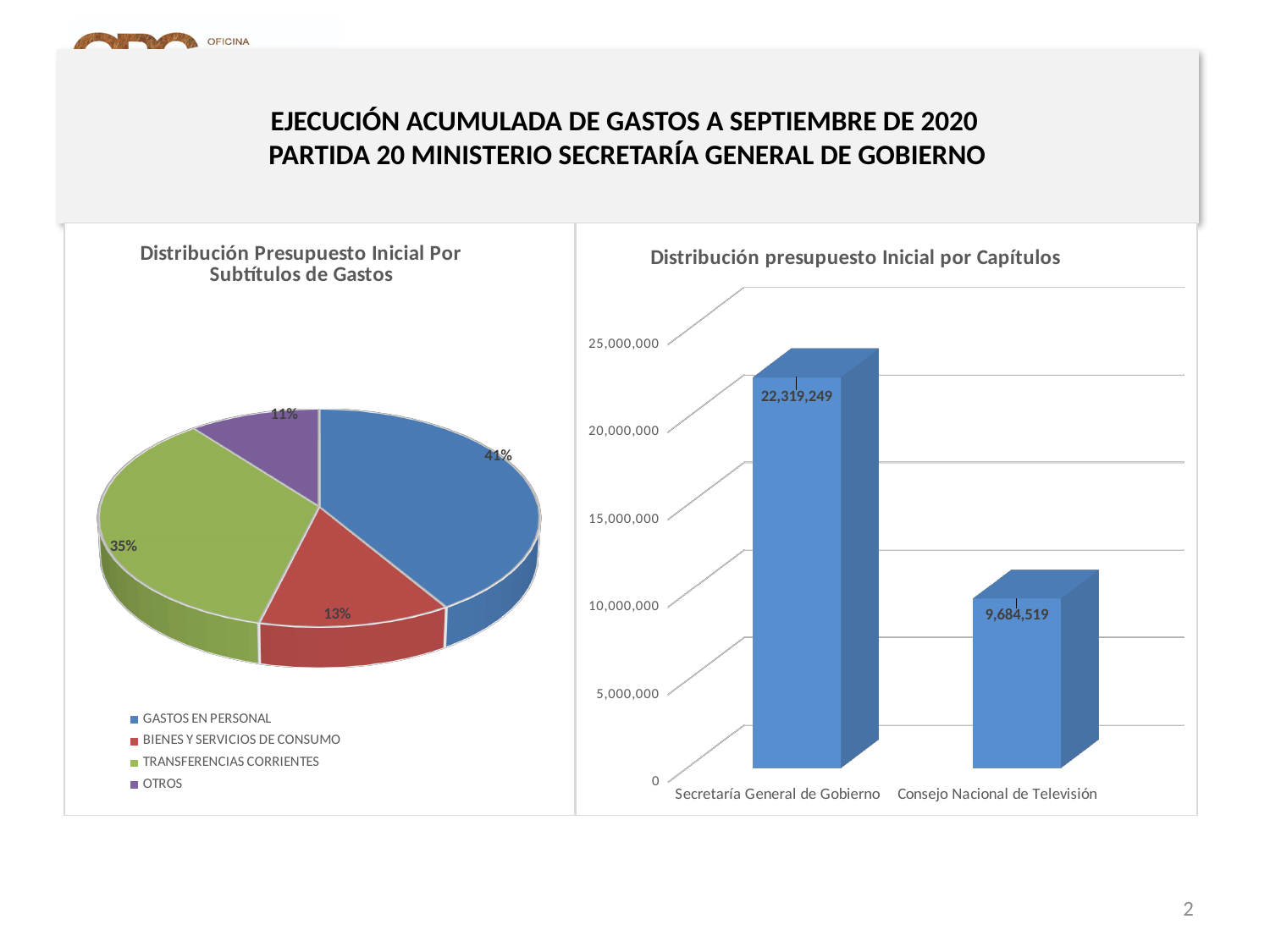
In the chart 'Distribución presupuesto Inicial por Capítulos', what is the value for Consejo Nacional de Televisión? 9,684,519 In the pie chart 'Distribución Presupuesto Inicial Por Subtítulos de Gastos', how many categories does the legend list? 4 In the pie chart 'Distribución Presupuesto Inicial Por Subtítulos de Gastos', what share does TRANSFERENCIAS CORRIENTES have? 35% In the chart 'Distribución presupuesto Inicial por Capítulos', is the value for Consejo Nacional de Televisión greater or less than 10,000,000? less In the chart 'Distribución presupuesto Inicial por Capítulos', what is the value for Secretaría General de Gobierno? 22,319,249 In the pie chart 'Distribución Presupuesto Inicial Por Subtítulos de Gastos', which category has the smallest share? OTROS In the pie chart 'Distribución Presupuesto Inicial Por Subtítulos de Gastos', what share does BIENES Y SERVICIOS DE CONSUMO have? 13% In the pie chart 'Distribución Presupuesto Inicial Por Subtítulos de Gastos', what colour represents OTROS? Purple In the pie chart 'Distribución Presupuesto Inicial Por Subtítulos de Gastos', which category has the largest share? GASTOS EN PERSONAL What kind of chart is 'Distribución presupuesto Inicial por Capítulos'? Bar chart In the chart 'Distribución presupuesto Inicial por Capítulos', what is the difference between Secretaría General de Gobierno and Consejo Nacional de Televisión? 12,634,730 In the pie chart 'Distribución Presupuesto Inicial Por Subtítulos de Gastos', what share does GASTOS EN PERSONAL have? 41%